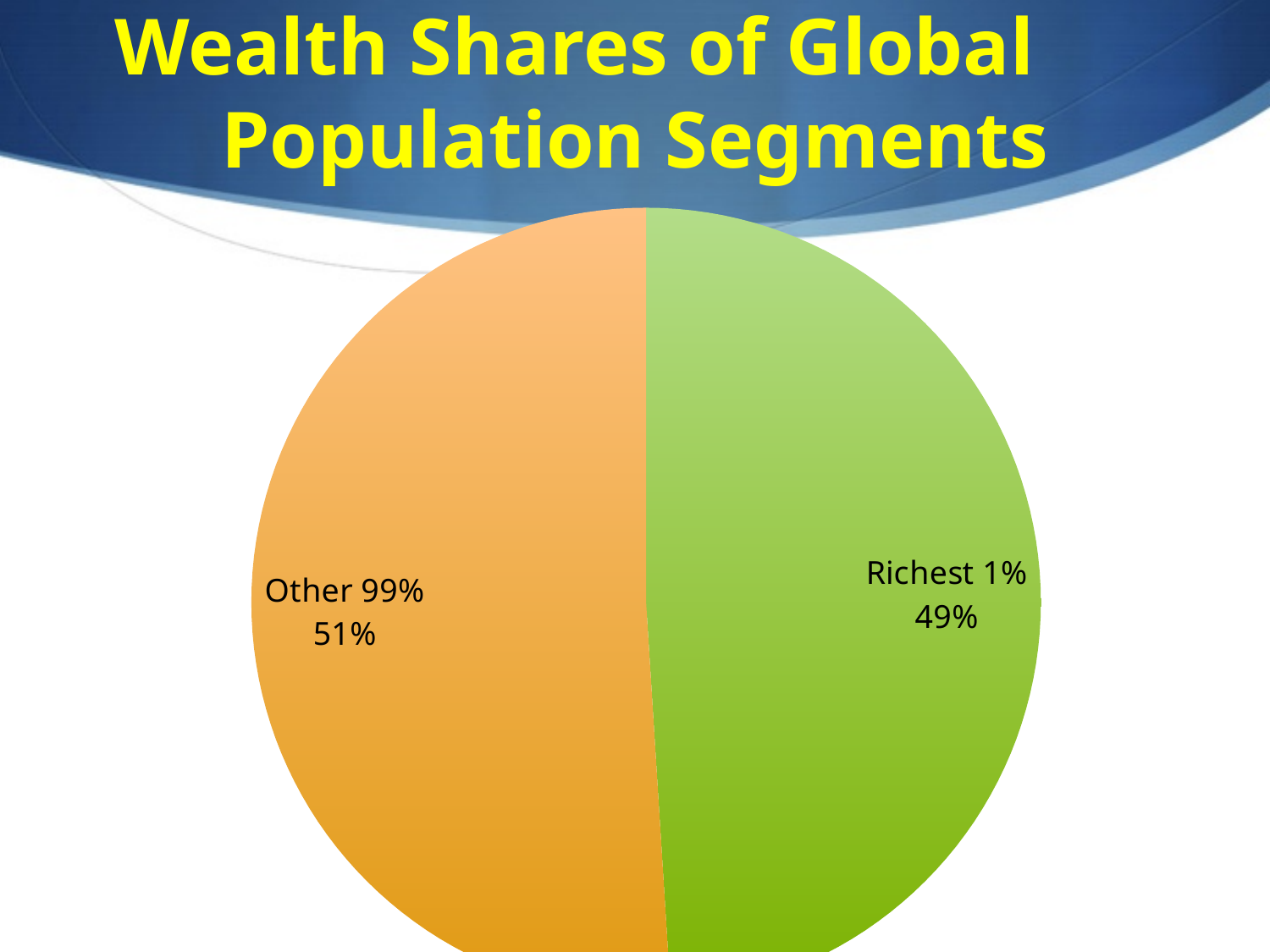
Which segment has the largest wealth share? Other 99% Is the Richest 1% share greater or less than 50%? less What colour is the Richest 1% slice? Green What is the title of the slide? Wealth Shares of Global Population Segments What kind of chart is shown on the slide? Pie chart What is the difference in percentage points between the Other 99% share and the Richest 1% share? 2 What share of wealth does the Richest 1% slice hold? 49% How many slices does the pie chart have? 2 Which slice is larger, Other 99% or Richest 1%? Other 99% Which segment has the smallest wealth share? Richest 1% What share of wealth does the Other 99% slice hold? 51%